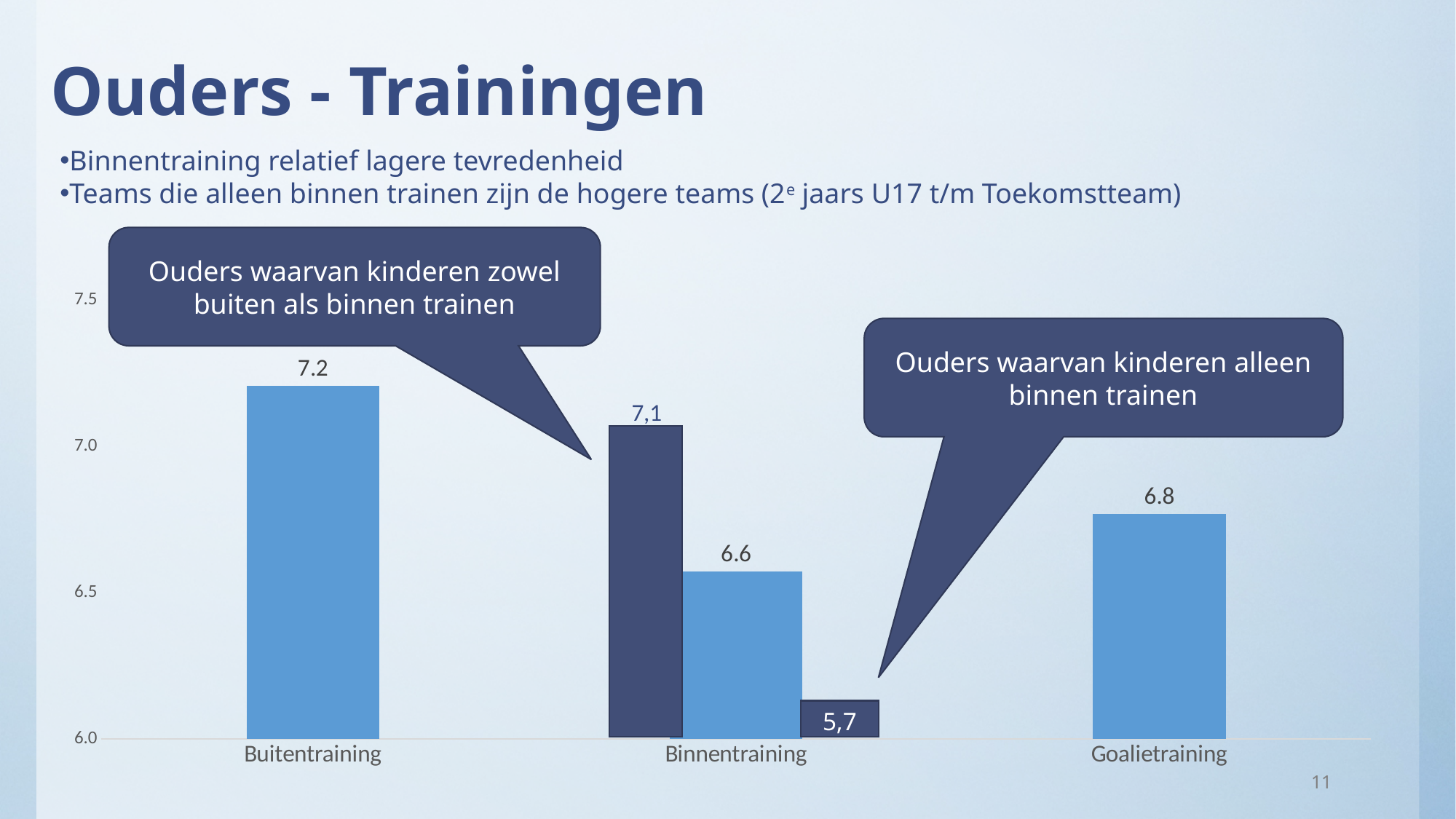
Which of the three training categories has the lowest light blue bar? Binnentraining What is the difference between the two dark blue bars (7,1 and 5,7)? 1,4 What is the value shown for Buitentraining? 7.2 What value is shown for parents whose children train both outside and inside ("zowel buiten als binnen trainen")? 7,1 What is the difference between the values for Buitentraining and Goalietraining? 0.4 How many training categories are shown on the x axis? 3 What value is shown for parents whose children only train inside ("alleen binnen trainen")? 5,7 What is the value of the light blue bar for Binnentraining? 6.6 What kind of chart is shown on the slide? Bar chart Which is larger, the value for Goalietraining or the light blue value for Binnentraining? Goalietraining What is the value shown for Goalietraining? 6.8 Which of the three training categories has the highest light blue bar? Buitentraining